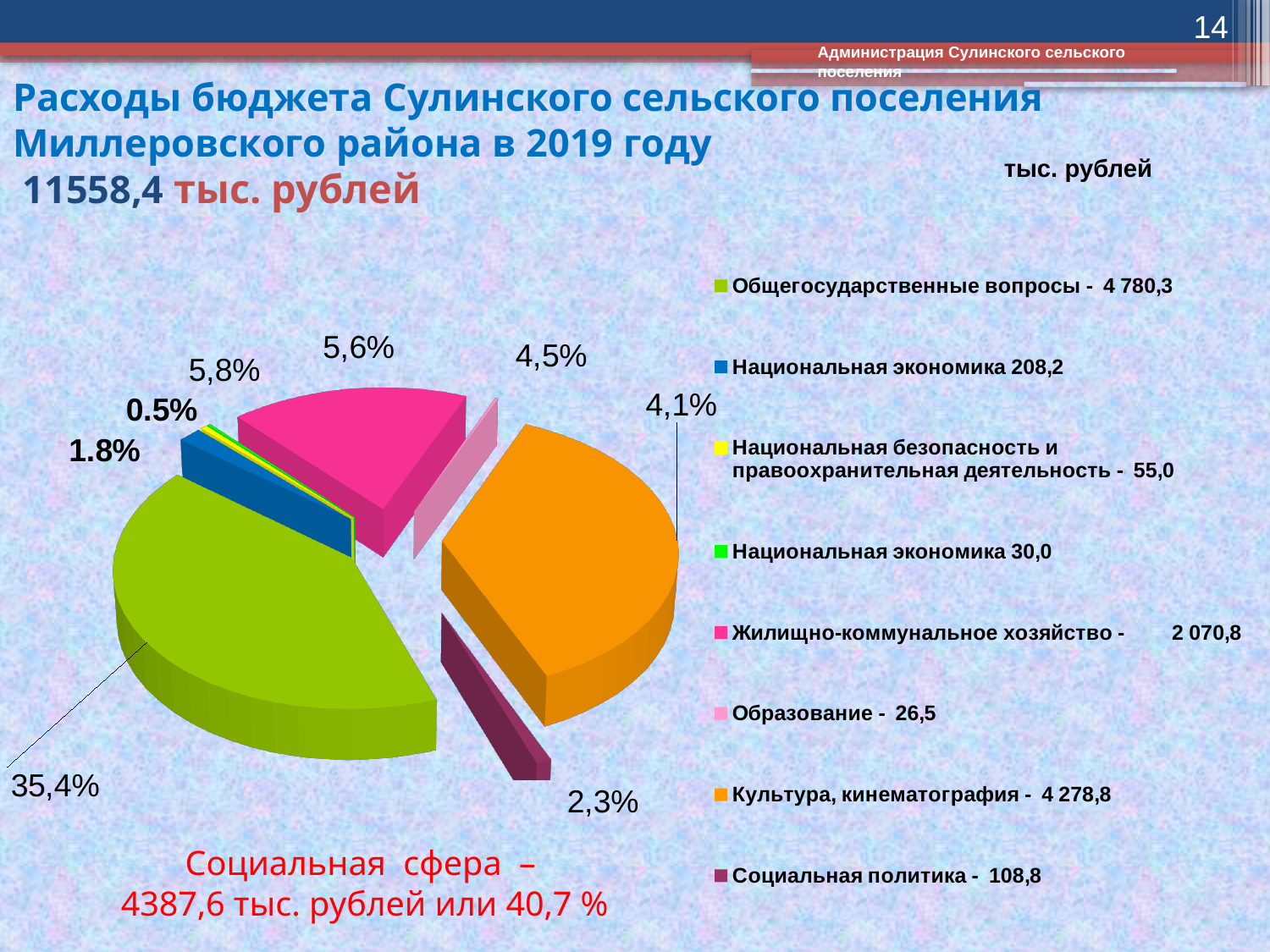
What kind of chart is shown on the slide? Pie chart Which legend category has the largest value? Общегосударственные вопросы What value is given in the legend for Культура, кинематография? 4 278,8 Which is larger: the value for Жилищно-коммунальное хозяйство or for Национальная безопасность и правоохранительная деятельность? Жилищно-коммунальное хозяйство What total budget expenditure amount is stated in the slide title? 11558,4 тыс. рублей What value is given in the legend for Общегосударственные вопросы? 4 780,3 What value is given in the legend for Жилищно-коммунальное хозяйство? 2 070,8 Which legend category has the smallest value? Образование How many entries does the legend of the pie chart list? 8 What is the difference between the values for Общегосударственные вопросы and Культура, кинематография? 501,5 What value is given in the legend for Образование? 26,5 What value is given in the legend for Социальная политика? 108,8